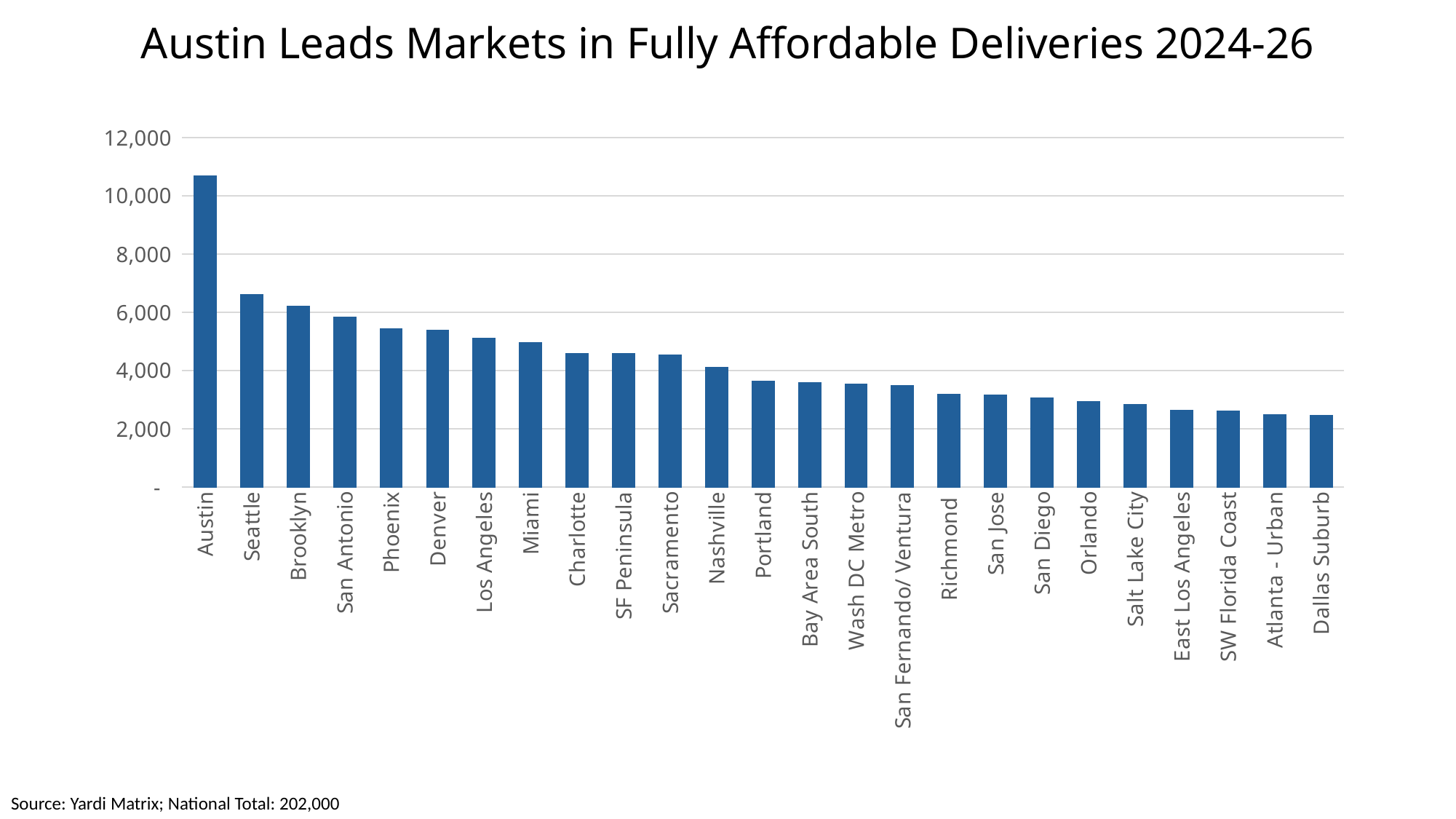
Is the value for Austin greater or less than 10,000? greater Is the value for Dallas Suburb greater or less than 2,000? greater Which has a larger value, Seattle or Brooklyn? Seattle What is the title of the chart? Austin Leads Markets in Fully Affordable Deliveries 2024-26 Is the value for Seattle greater or less than 6,000? greater What kind of chart is shown on the slide? bar chart How many markets are shown in the chart? 25 Which market has the highest value in the chart? Austin Do the values rise or fall moving from left to right across the markets? fall